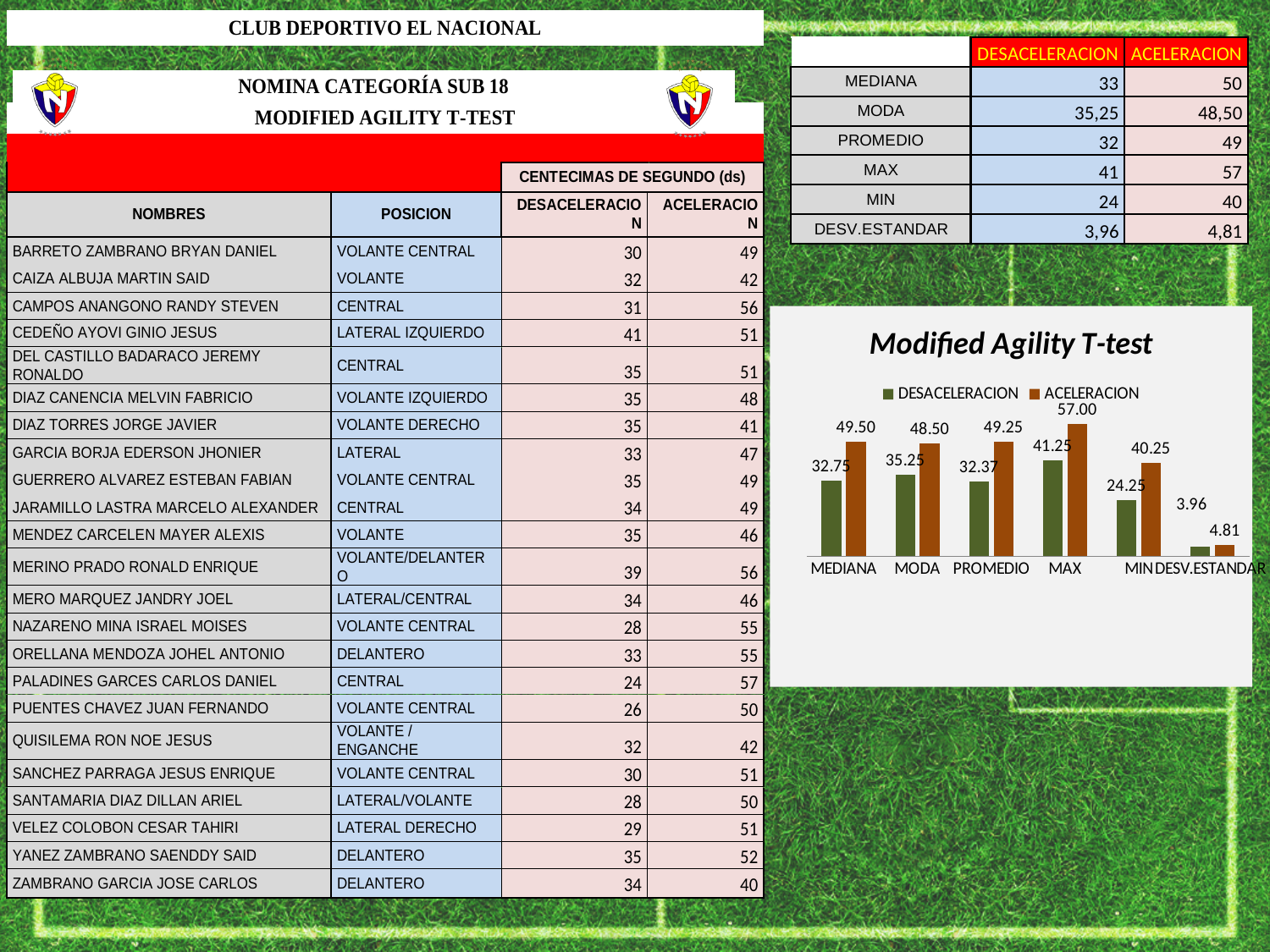
How many categories are shown on the x axis of the 'Modified Agility T-test' chart? 6 In the 'Modified Agility T-test' chart, what is the difference between the ACELERACION and DESACELERACION values for MEDIANA? 16.75 In the 'Modified Agility T-test' chart, what is the ACELERACION value for DESV.ESTANDAR? 4.81 In the 'Modified Agility T-test' chart, which category has the highest ACELERACION value? MAX In the 'Modified Agility T-test' chart, what is the DESACELERACION value for MIN? 24.25 In the 'Modified Agility T-test' chart, which category has the lowest DESACELERACION value? DESV.ESTANDAR What colour are the ACELERACION bars in the 'Modified Agility T-test' chart? orange-brown What type of chart is the 'Modified Agility T-test' chart? bar chart How many series does the legend of the 'Modified Agility T-test' chart list? 2 In the 'Modified Agility T-test' chart, which is larger for PROMEDIO: DESACELERACION or ACELERACION? ACELERACION In the 'Modified Agility T-test' chart, what is the DESACELERACION value for MODA? 35.25 In the 'Modified Agility T-test' chart, what is the ACELERACION value for MAX? 57.00